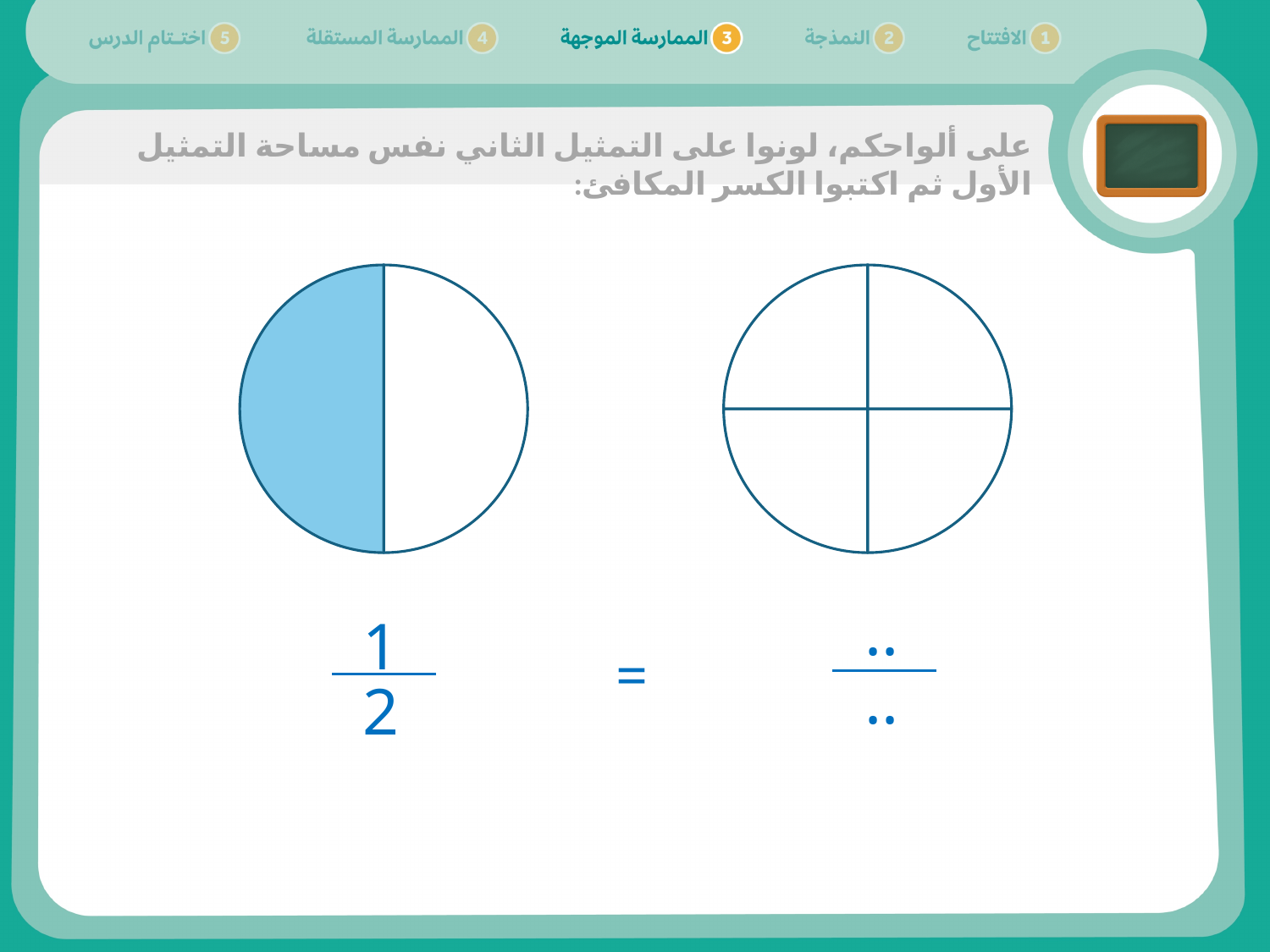
How many equal parts is the right circle divided into? 4 What share of the left circle is shaded? 1/2 What colour is the shaded part of the left circle? light blue How many parts of the right circle are shaded? 0 How many equal parts is the left circle divided into? 2 Which circle is divided into more parts, the left one or the right one? the right one What symbol appears between the two fractions below the circles? = What fraction is written below the left circle? 1/2